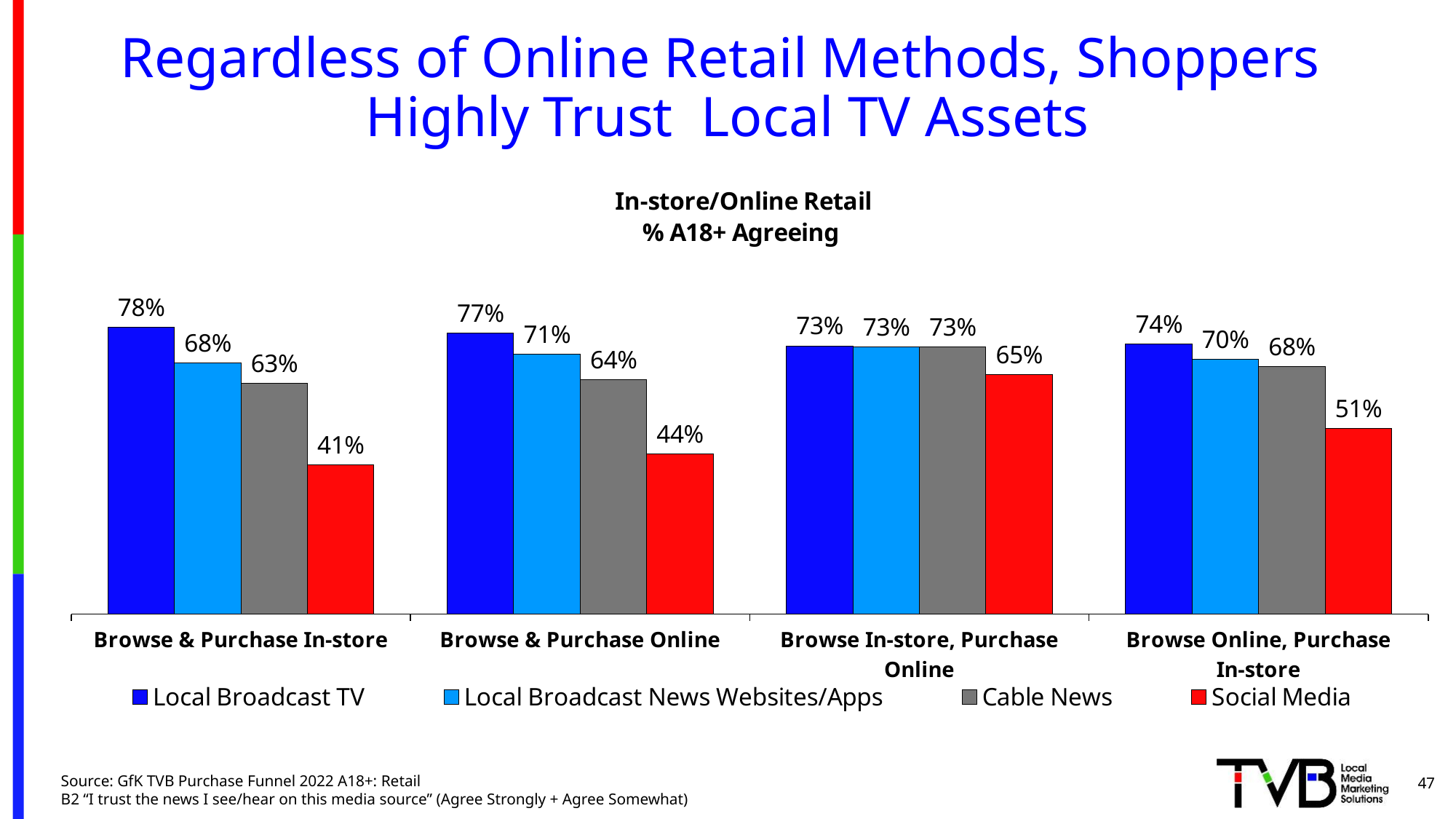
Which category has the lowest Social Media value? Browse & Purchase In-store What is the value for Cable News in the Browse Online, Purchase In-store category? 68% What colour represents Social Media in the chart? Red Which is larger in the Browse Online, Purchase In-store category: Local Broadcast News Websites/Apps or Social Media? Local Broadcast News Websites/Apps What is the value for Social Media in the Browse & Purchase Online category? 44% What is the difference between Local Broadcast TV and Social Media in the Browse & Purchase In-store category? 37 percentage points How many series does the legend list? 4 What is the value for Local Broadcast News Websites/Apps in the Browse In-store, Purchase Online category? 73% Which category has the highest Local Broadcast TV value? Browse & Purchase In-store What kind of chart is shown on the slide? Bar chart How many categories are shown on the x axis? 4 What is the value for Local Broadcast TV in the Browse & Purchase In-store category? 78%